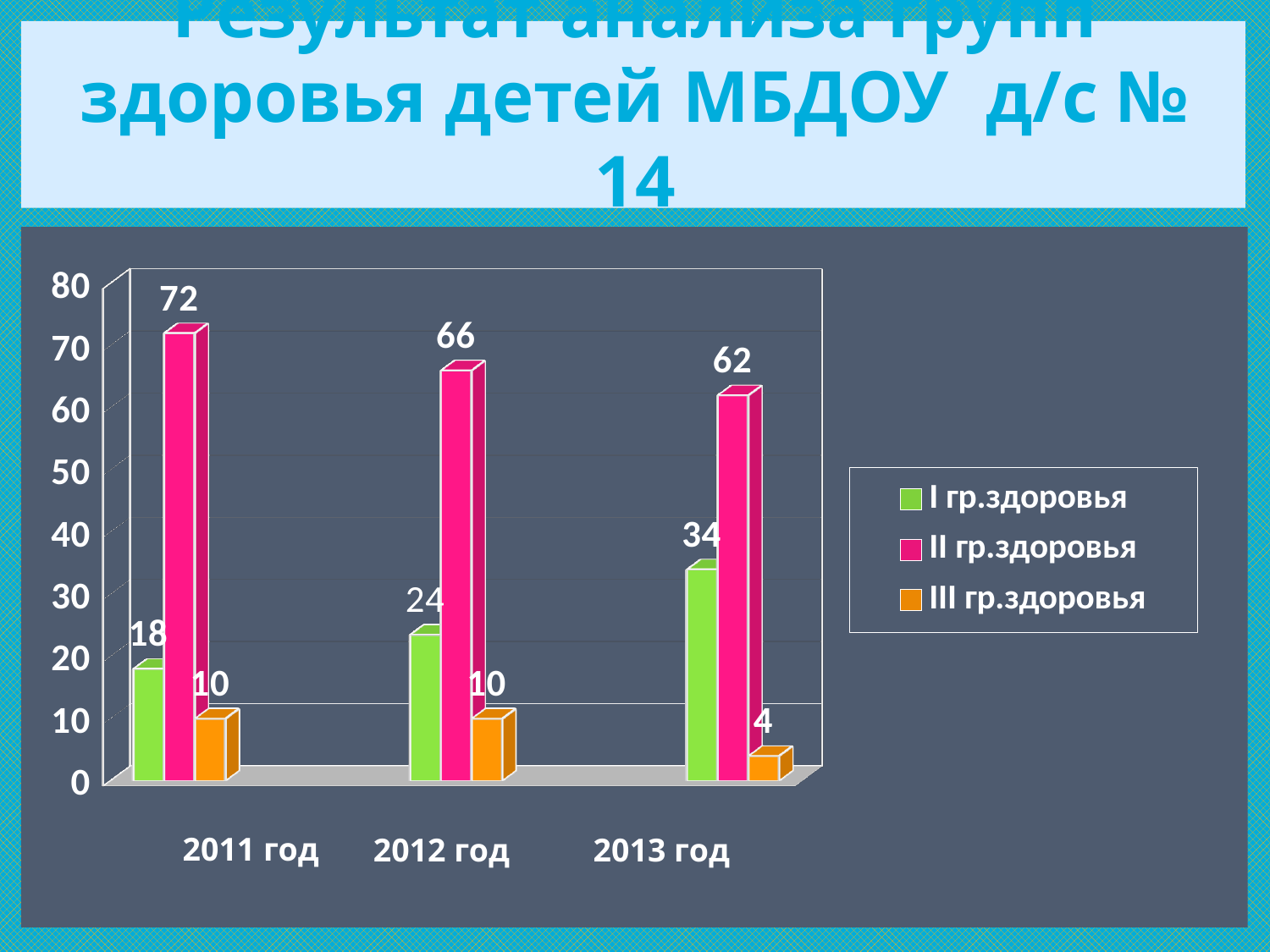
In which year is the value for II гр.здоровья highest? 2011 год How many series does the legend list? 3 How many years are shown on the x axis? 3 In which year is the value for I гр.здоровья lowest? 2011 год Which is larger: I гр.здоровья in 2013 год or I гр.здоровья in 2012 год? I гр.здоровья in 2013 год What is the value for II гр.здоровья in 2011 год? 72 What is the value for I гр.здоровья in 2013 год? 34 What kind of chart is shown on the slide? bar chart What is the value for I гр.здоровья in 2012 год? 24 What is the difference between the II гр.здоровья values for 2011 год and 2013 год? 10 What is the value for III гр.здоровья in 2013 год? 4 Does the value for I гр.здоровья rise or fall from 2011 год to 2013 год? rise